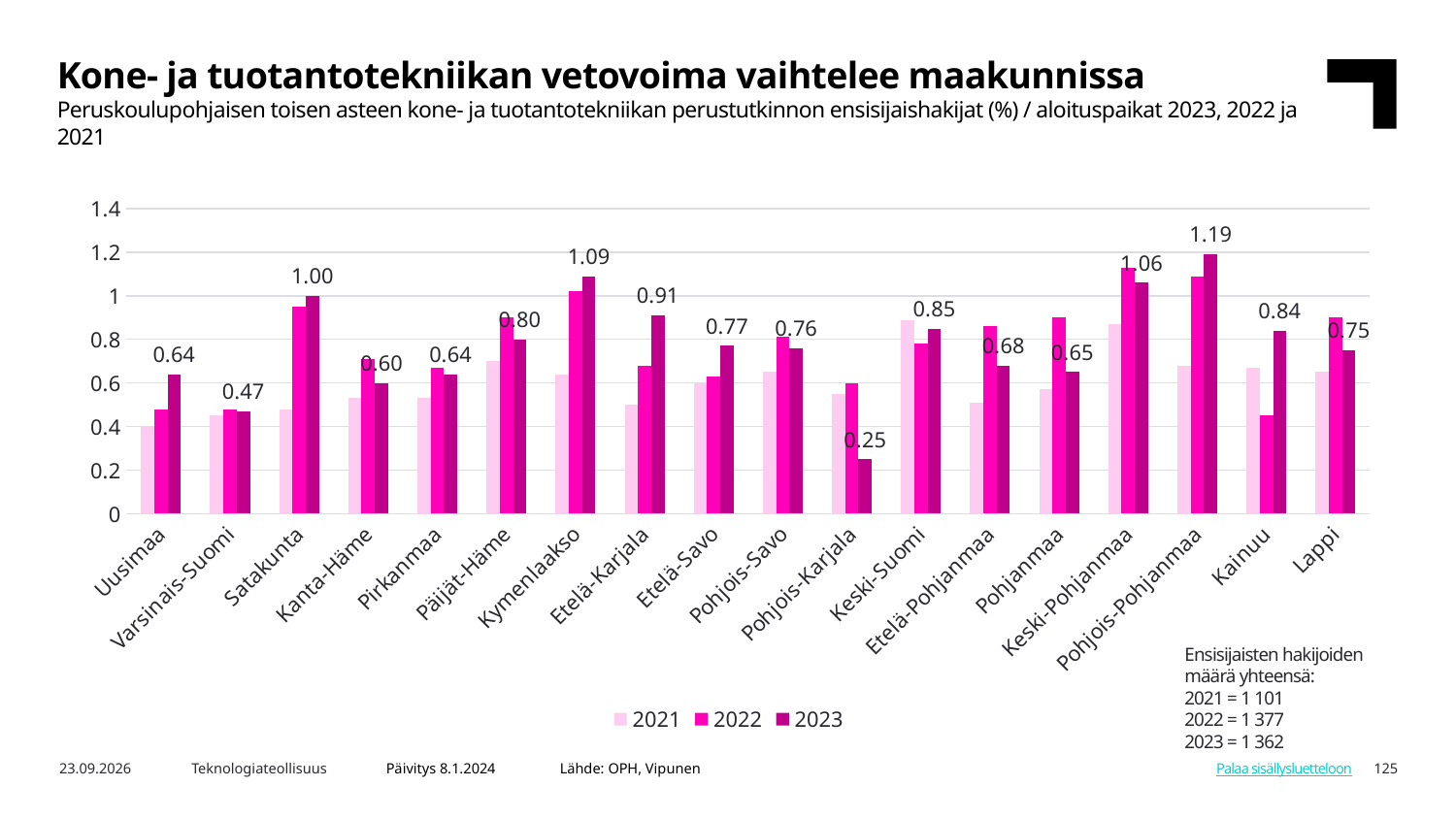
Which region has the lowest 2023 value? Pohjois-Karjala What is the 2023 value for Kymenlaakso? 1.09 How many series does the legend list? 3 What is the 2023 value for Pohjois-Pohjanmaa? 1.19 What kind of chart is shown on the slide? bar chart What is the difference between the 2023 values for Pohjois-Pohjanmaa and Pohjois-Karjala? 0.94 Is the 2022 value for Satakunta greater or less than 0.8? greater How many regions (categories) are shown on the x axis? 18 What is the 2023 value for Varsinais-Suomi? 0.47 Is the 2021 value for Uusimaa greater or less than 0.6? less Which has the larger 2023 value, Etelä-Karjala or Keski-Suomi? Etelä-Karjala Which region has the highest 2023 value? Pohjois-Pohjanmaa